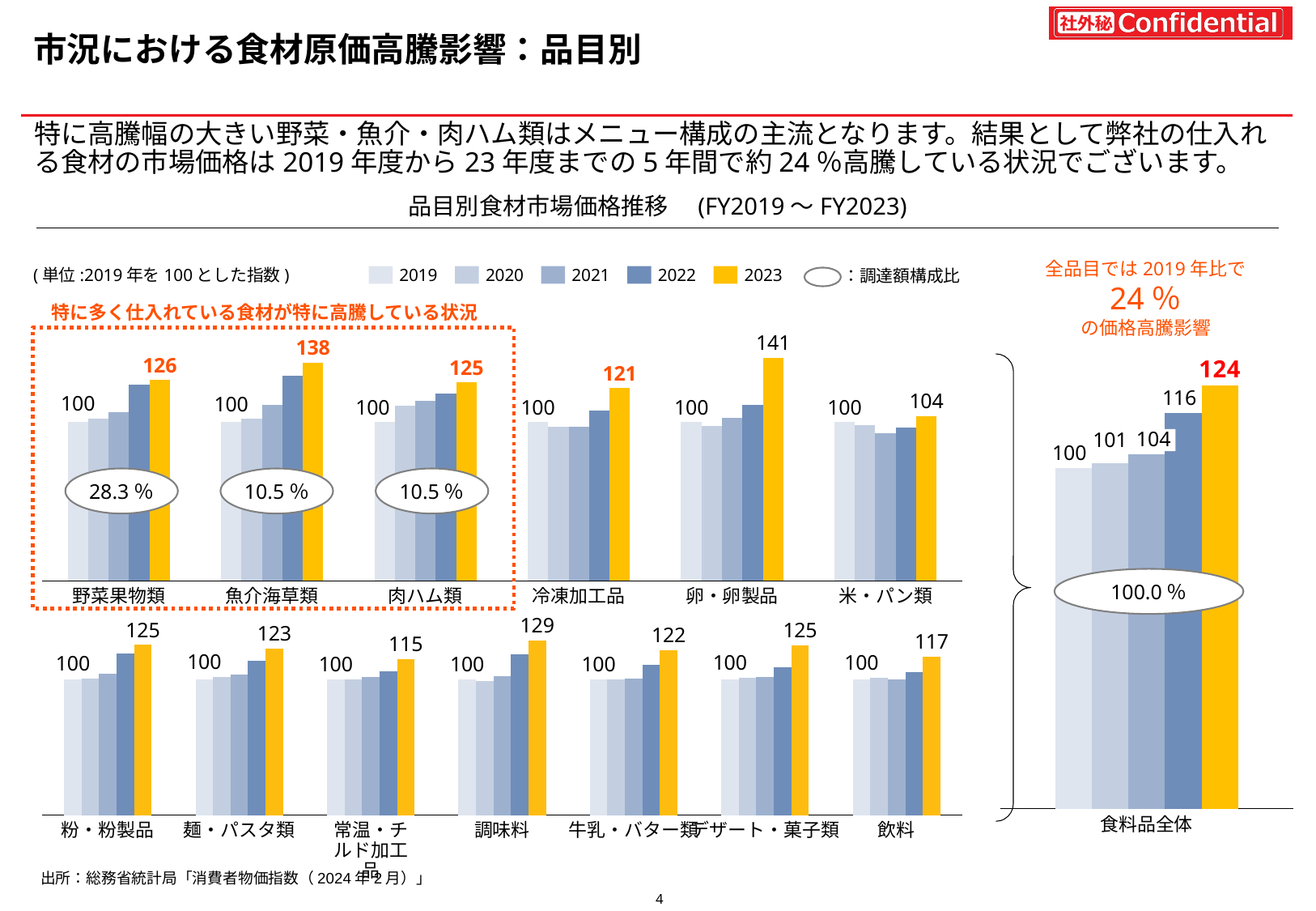
In the 野菜果物類 chart, what is the difference between the 2023 value and the 2019 value? 26 In the 食料品全体 chart on the right, what is the value for 2021? 104 Among the 2023 values shown across all the item charts, which item has the highest 2023 value? 卵・卵製品 In the 卵・卵製品 chart, what is the value for 2023? 141 In the 食料品全体 chart on the right, what is the difference between the 2023 value and the 2019 value? 24 How many series does the legend list for the bar charts? 5 What kind of chart is used for 食料品全体 on the right? bar chart Which is larger: the 2023 value in the 調味料 chart or the 2023 value in the 飲料 chart? 調味料 Among the 2023 values shown across all the item charts, which item has the lowest 2023 value? 米・パン類 In the 魚介海草類 chart, what is the value for 2023? 138 In the 食料品全体 chart on the right, what is the value for 2023? 124 In the 食料品全体 chart on the right, do the values rise or fall from 2019 to 2023? rise